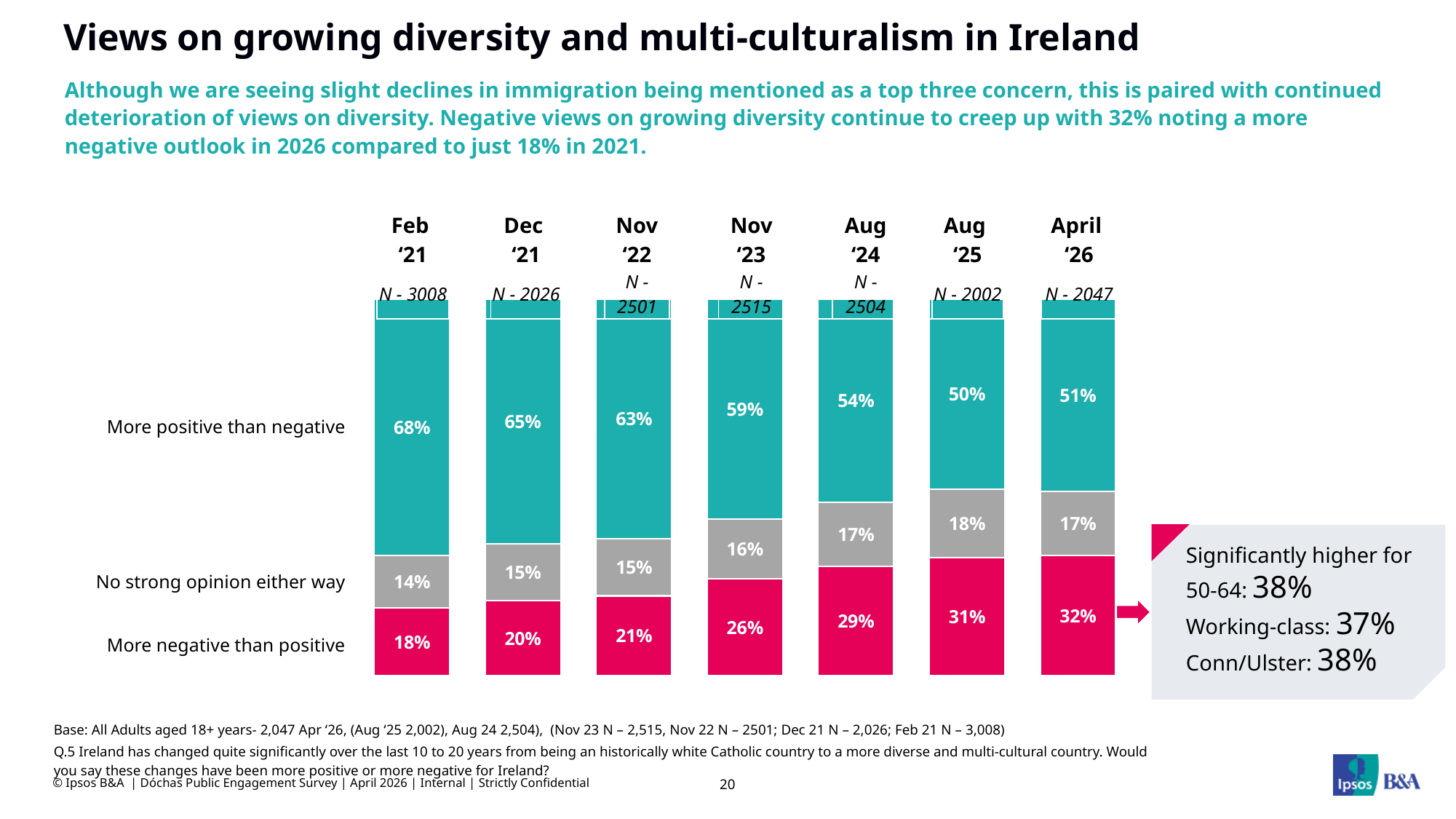
How many survey waves are shown in the chart? 7 What percentage of respondents were 'More positive than negative' in Feb '21? 68% By how many percentage points did the 'More negative than positive' share change between Feb '21 and April '26? 14 percentage points What percentage had 'No strong opinion either way' in Aug '25? 18% What percentage of respondents were 'More negative than positive' in April '26? 32% Which is larger: the 'More positive than negative' share in Aug '24 or in Aug '25? Aug '24 What is the sample size (N) shown for the April '26 wave? N - 2047 In which survey wave was the 'More positive than negative' share highest? Feb '21 What kind of chart is used on this slide? Stacked bar chart Does the 'More negative than positive' share rise or fall from Feb '21 to April '26? Rise In which survey wave was the 'More negative than positive' share lowest? Feb '21 What percentage of respondents were 'More negative than positive' in Nov '23? 26%